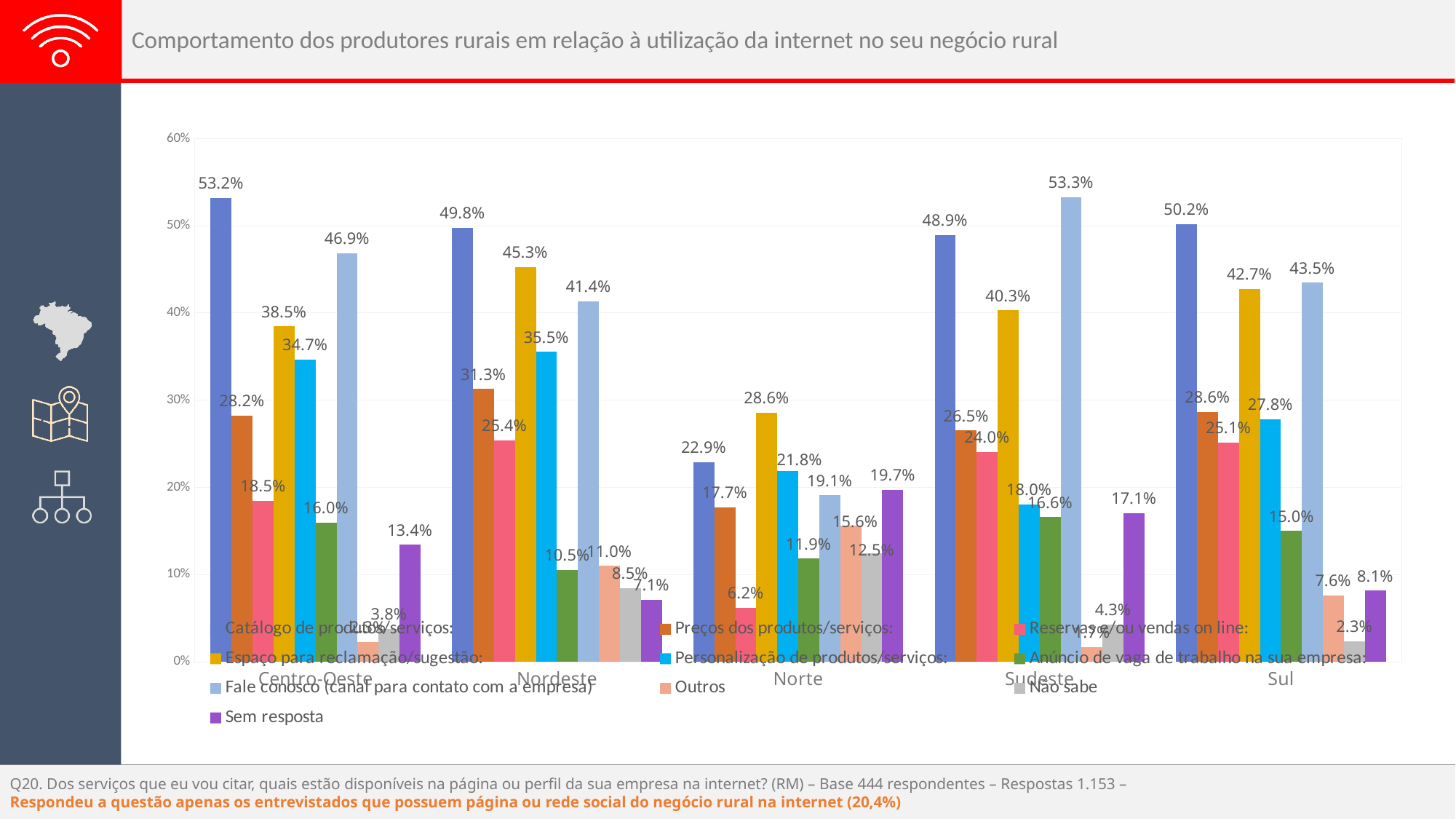
What is the value for Espaço para reclamação/sugestão in Nordeste? 45.3% What is the value for Catálogo de produtos/serviços in Centro-Oeste? 53.2% What is the value for Reservas e/ou vendas on line in Norte? 6.2% How many regions are shown on the x axis? 5 Which region has the highest value for Catálogo de produtos/serviços? Centro-Oeste What is the difference between Catálogo de produtos/serviços and Preços dos produtos/serviços in Sul? 21.6% Which is larger in Sudeste: Catálogo de produtos/serviços or Fale conosco (canal para contato com a empresa)? Fale conosco (canal para contato com a empresa) How many series does the legend list? 10 What is the value for Fale conosco (canal para contato com a empresa) in Sudeste? 53.3% Is the value for Personalização de produtos/serviços in Nordeste greater or less than 30%? greater Which region has the lowest value for Espaço para reclamação/sugestão? Norte What kind of chart is shown on the slide? Bar chart